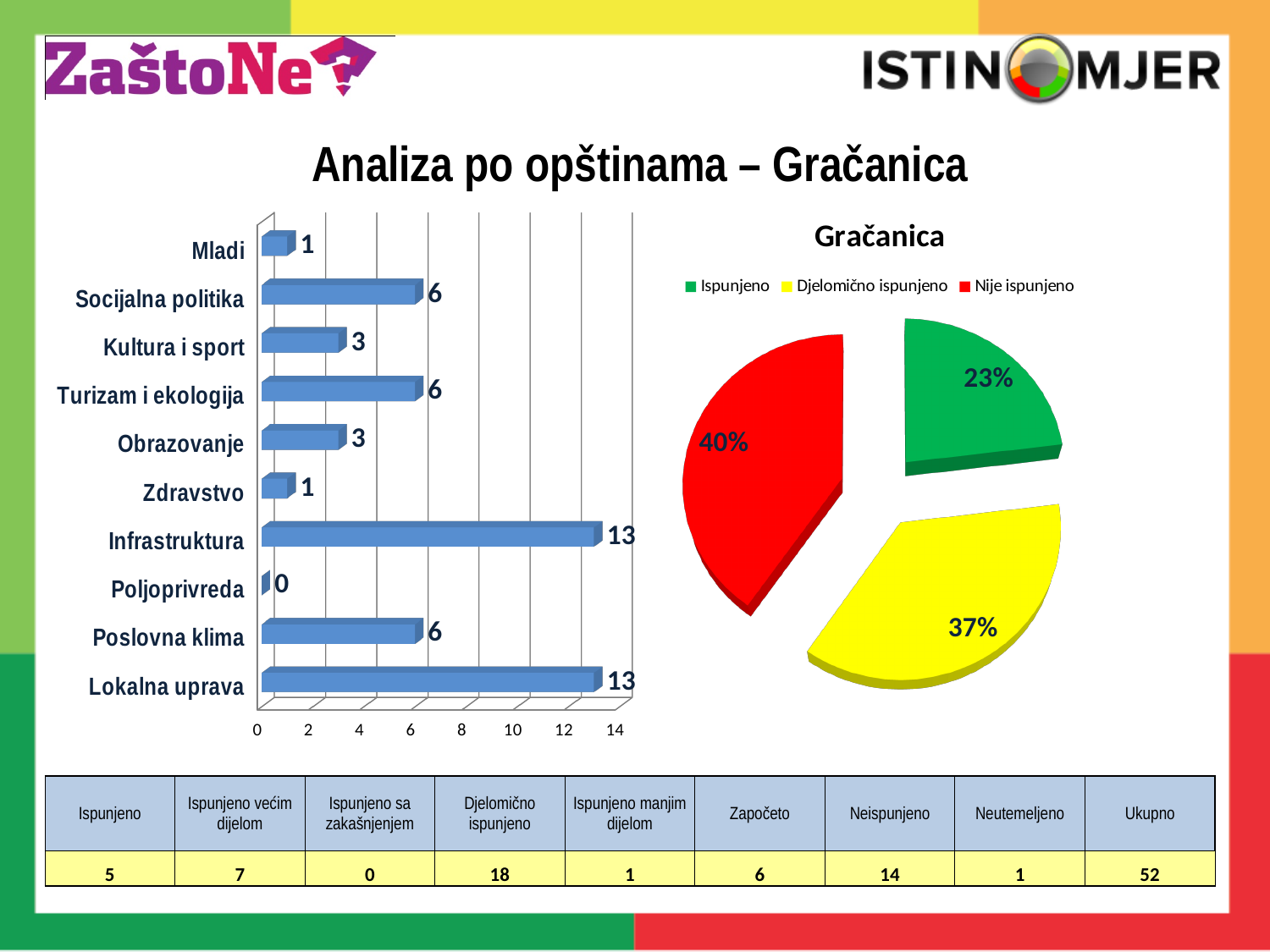
In the pie chart titled Gračanica, what colour is the Ispunjeno slice? Green In the bar chart on the left, which category has the lowest value? Poljoprivreda In the bar chart on the left, what is the value for Poslovna klima? 6 How many categories are shown in the bar chart on the left? 10 In the pie chart titled Gračanica, which slice is the largest? Nije ispunjeno In the bar chart on the left, what is the difference between the values for Lokalna uprava and Socijalna politika? 7 In the bar chart on the left, what is the value for Infrastruktura? 13 In the bar chart on the left, what is the value for Kultura i sport? 3 In the pie chart titled Gračanica, what share does Djelomično ispunjeno have? 37% How many entries does the legend of the pie chart titled Gračanica list? 3 What kind of chart is the chart on the left of the slide? Bar chart In the bar chart on the left, which is larger, the value for Turizam i ekologija or the value for Zdravstvo? Turizam i ekologija